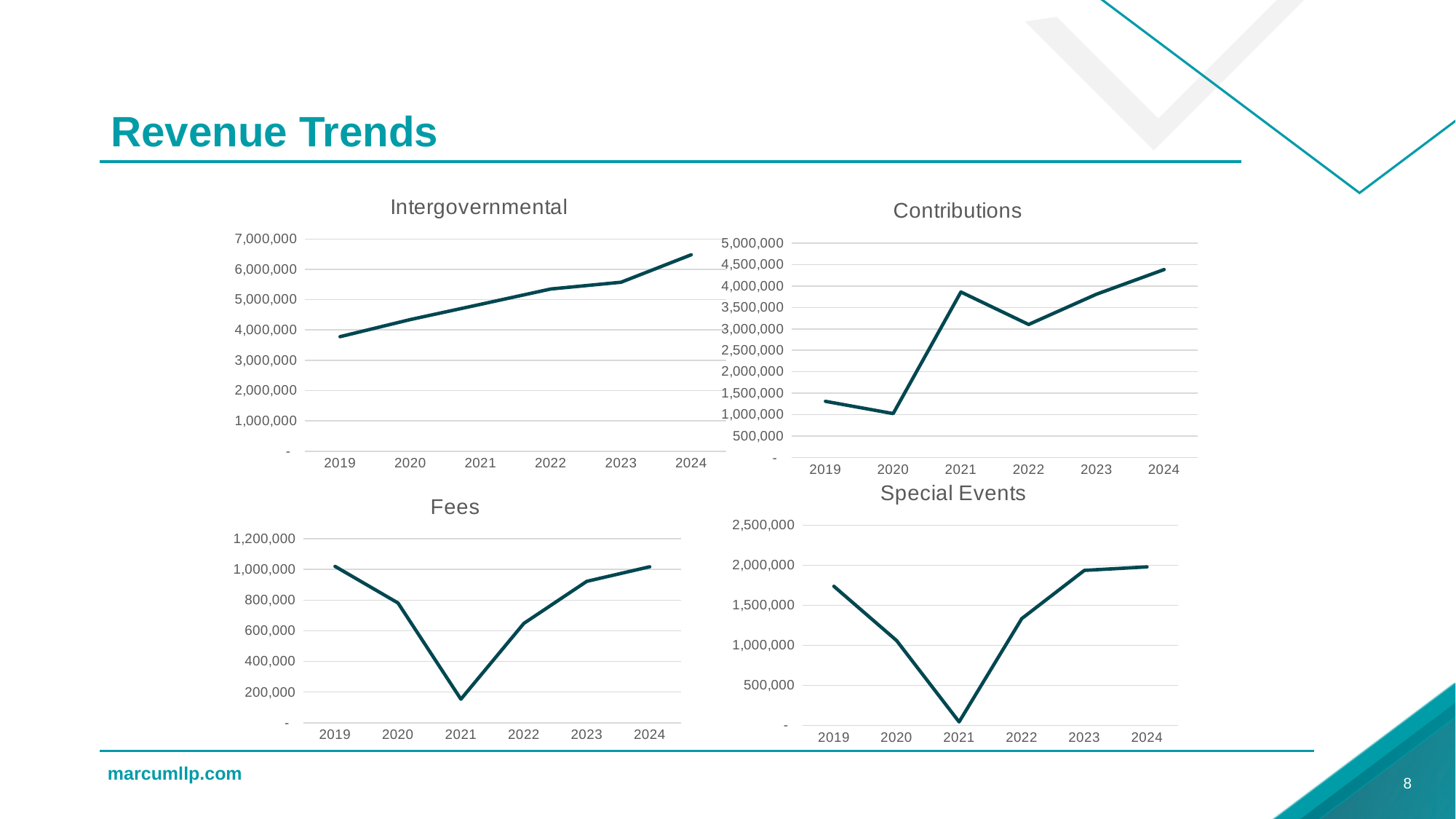
In the Intergovernmental chart, is the value for 2024 greater or less than 6,000,000? greater In the Fees chart, which year has the lowest value? 2021 In the Contributions chart, which year has the lowest value? 2020 What kind of chart is the Intergovernmental chart? line chart In the Contributions chart, which is larger, the value for 2021 or the value for 2022? 2021 How many years are plotted on the x axis of the Fees chart? 6 In the Fees chart, is the value for 2021 greater or less than 200,000? less In the Intergovernmental chart, do the values rise or fall from 2019 to 2024? rise How many charts are shown on the slide? 4 In the Intergovernmental chart, which year has the highest value? 2024 In the Special Events chart, which year has the lowest value? 2021 In the Contributions chart, which year has the highest value? 2024